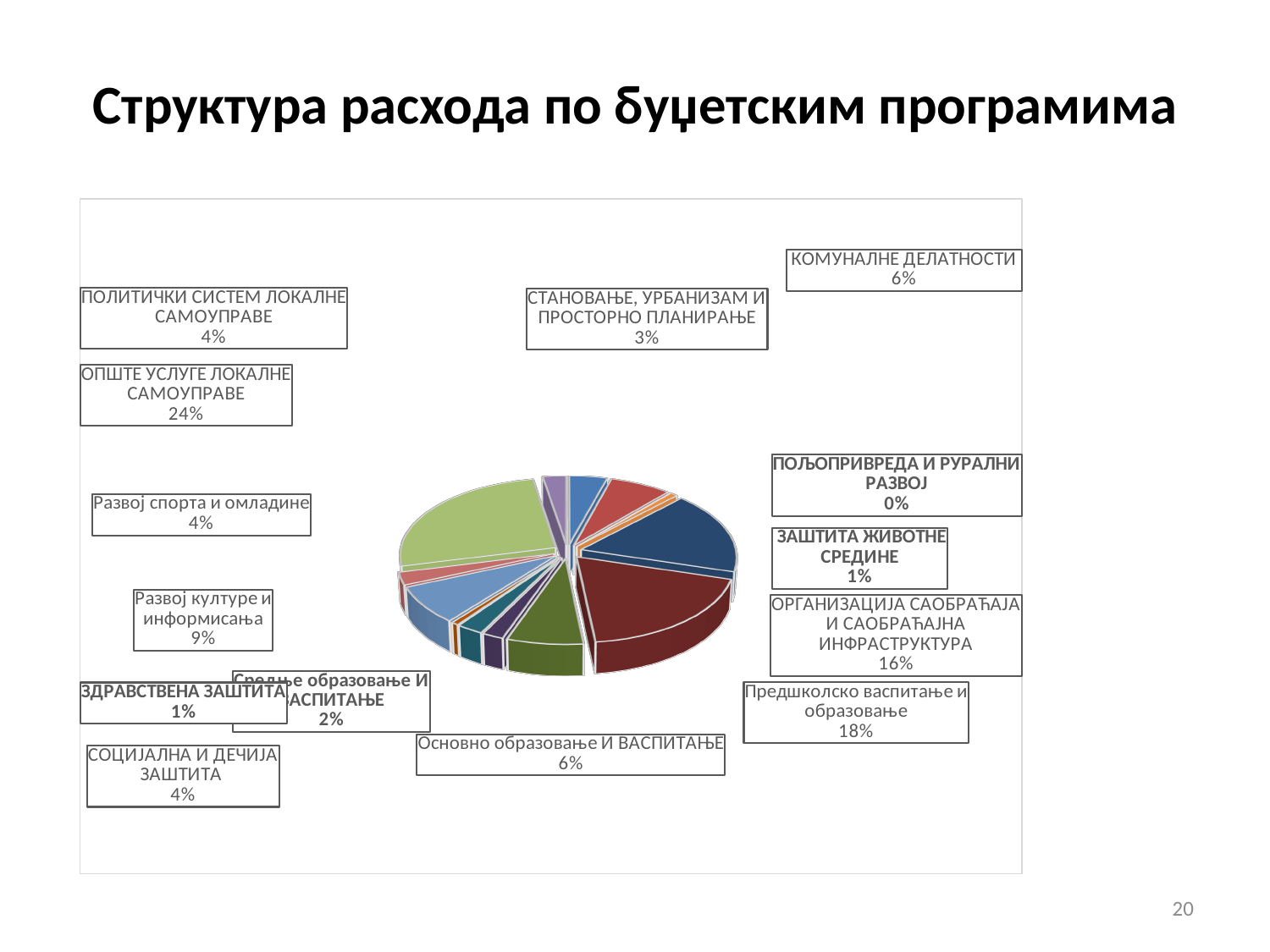
What share of expenditure goes to ОПШТЕ УСЛУГЕ ЛОКАЛНЕ САМОУПРАВЕ? 24% Which budget programme has the smallest share of expenditure? ПОЉОПРИВРЕДА И РУРАЛНИ РАЗВОЈ Which budget programme has the largest share of expenditure? ОПШТЕ УСЛУГЕ ЛОКАЛНЕ САМОУПРАВЕ What share is labelled for Развој културе и информисања? 9% What is the difference in percentage points between ОПШТЕ УСЛУГЕ ЛОКАЛНЕ САМОУПРАВЕ and Предшколско васпитање и образовање? 6 percentage points What percentage is shown for Предшколско васпитање и образовање? 18% How many budget programmes are labelled on the pie chart? 14 What kind of chart is shown on the slide? Pie chart What is the title of the slide? Структура расхода по буџетским програмима What percentage is shown for СТАНОВАЊЕ, УРБАНИЗАМ И ПРОСТОРНО ПЛАНИРАЊЕ? 3% Which has a larger share: Развој културе и информисања or КОМУНАЛНЕ ДЕЛАТНОСТИ? Развој културе и информисања What percentage is shown for ОРГАНИЗАЦИЈА САОБРАЋАЈА И САОБРАЋАЈНА ИНФРАСТРУКТУРА? 16%